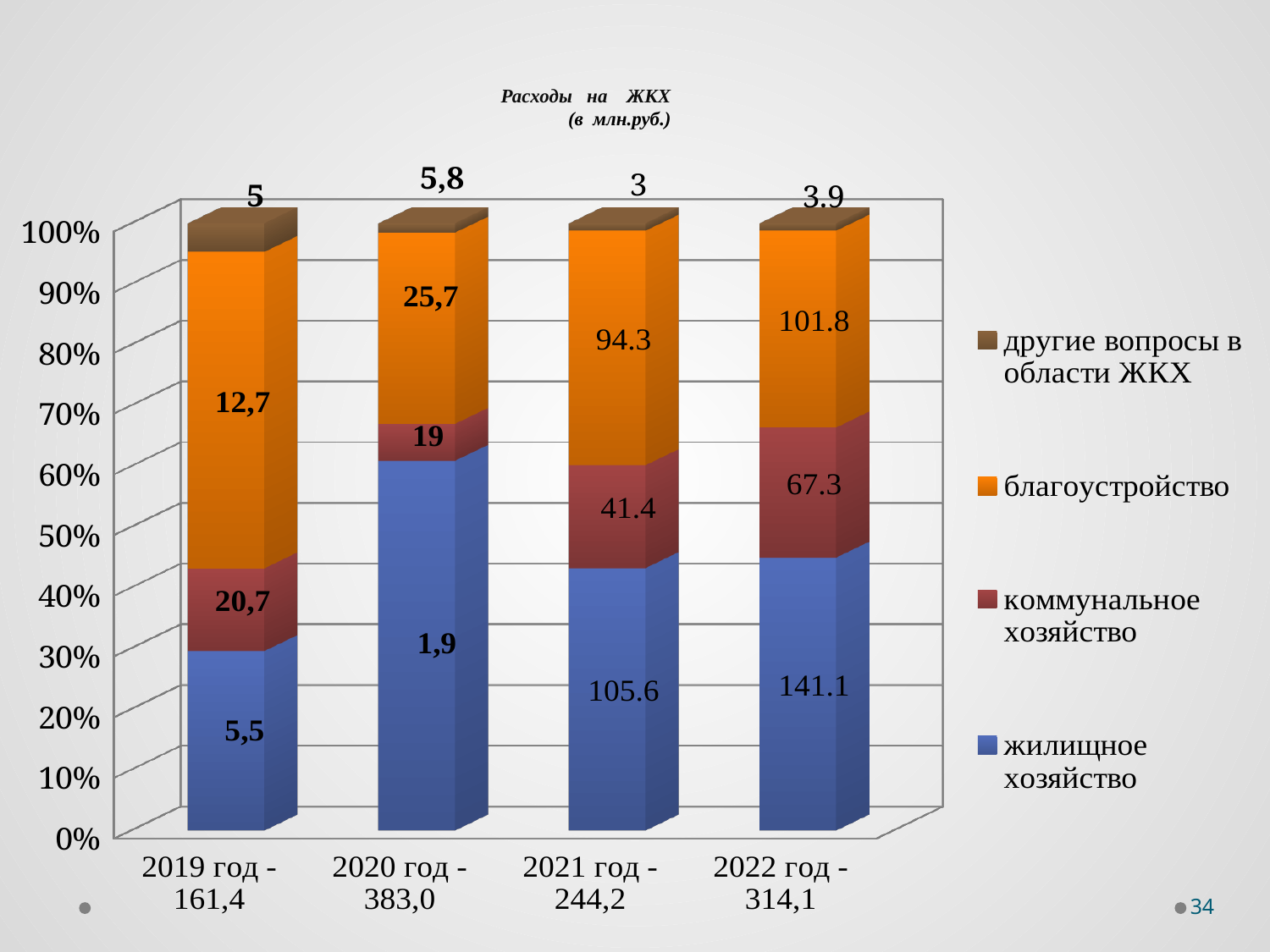
What is the data label for жилищное хозяйство in the 2022 bar? 141.1 What is the data label for благоустройство in the 2020 bar? 25,7 What is the data label for коммунальное хозяйство in the 2019 bar? 20,7 Which year has the larger коммунальное хозяйство label, 2021 or 2022? 2022 What value is shown above the 2021 bar for другие вопросы в области ЖКХ? 3 What kind of chart is shown on the slide? stacked bar chart In which year is the label for другие вопросы в области ЖКХ the lowest? 2021 Is the share of жилищное хозяйство in the 2020 bar greater or less than 50%? greater How many series does the legend list? 4 How many year categories are shown on the x axis? 4 What is the difference between the жилищное хозяйство labels for 2022 (141.1) and 2021 (105.6)? 35.5 In which year is the label for другие вопросы в области ЖКХ the highest? 2020